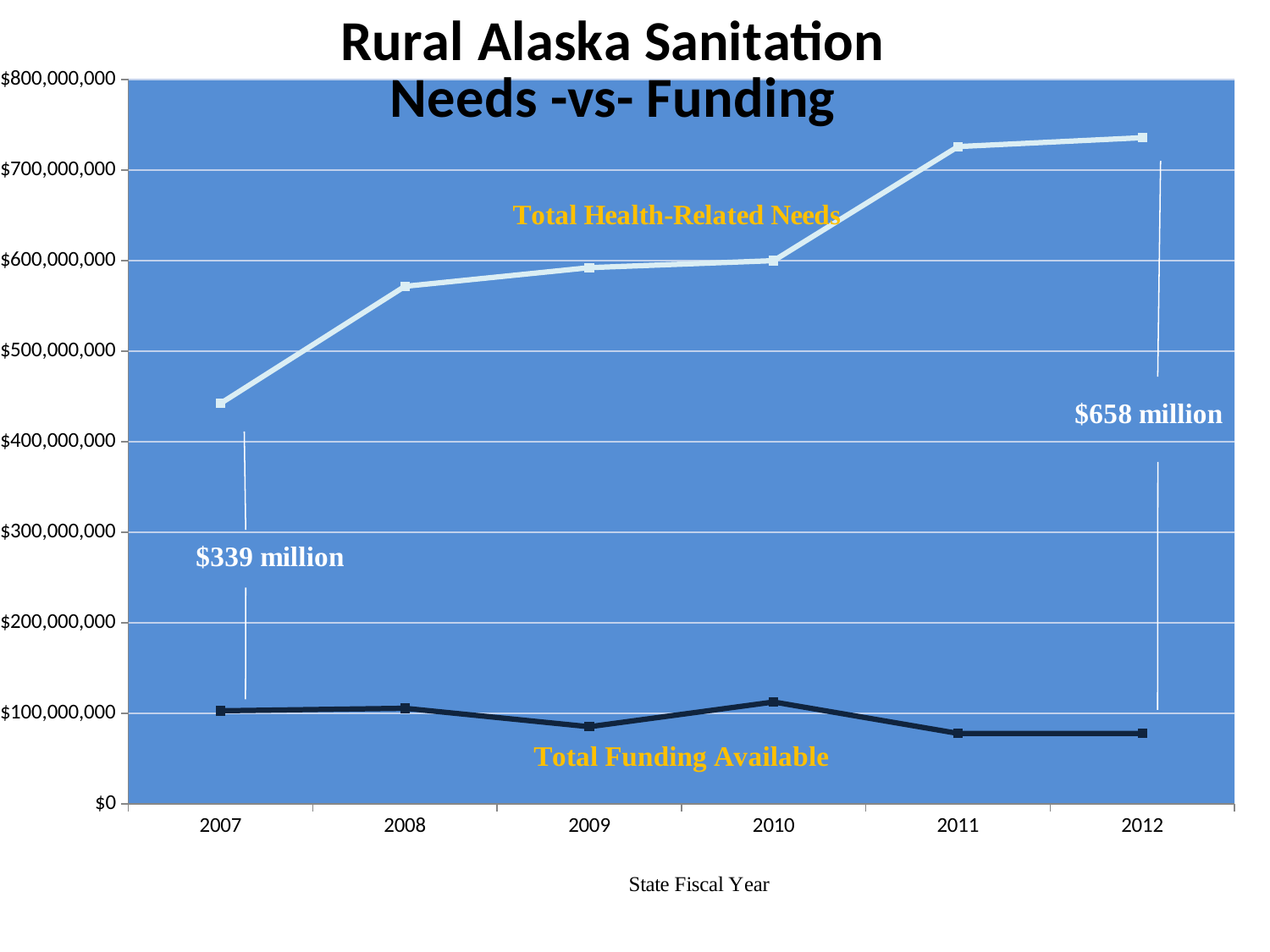
What kind of chart is shown on the slide? line chart Does Total Health-Related Needs generally rise or fall from 2007 to 2012? rise What gap between needs and funding is annotated for 2012? $658 million How many data series are plotted on the chart? 2 In which year is Total Funding Available highest? 2010 Is the value for Total Funding Available in 2011 greater or less than $100,000,000? less What gap between needs and funding is annotated for 2007? $339 million Is the value for Total Health-Related Needs in 2007 greater or less than $400,000,000? greater Is the value for Total Health-Related Needs in 2011 greater or less than $700,000,000? greater What is the label of the x axis? State Fiscal Year How many state fiscal years are plotted on the x axis? 6 What is the title of the chart? Rural Alaska Sanitation Needs -vs- Funding